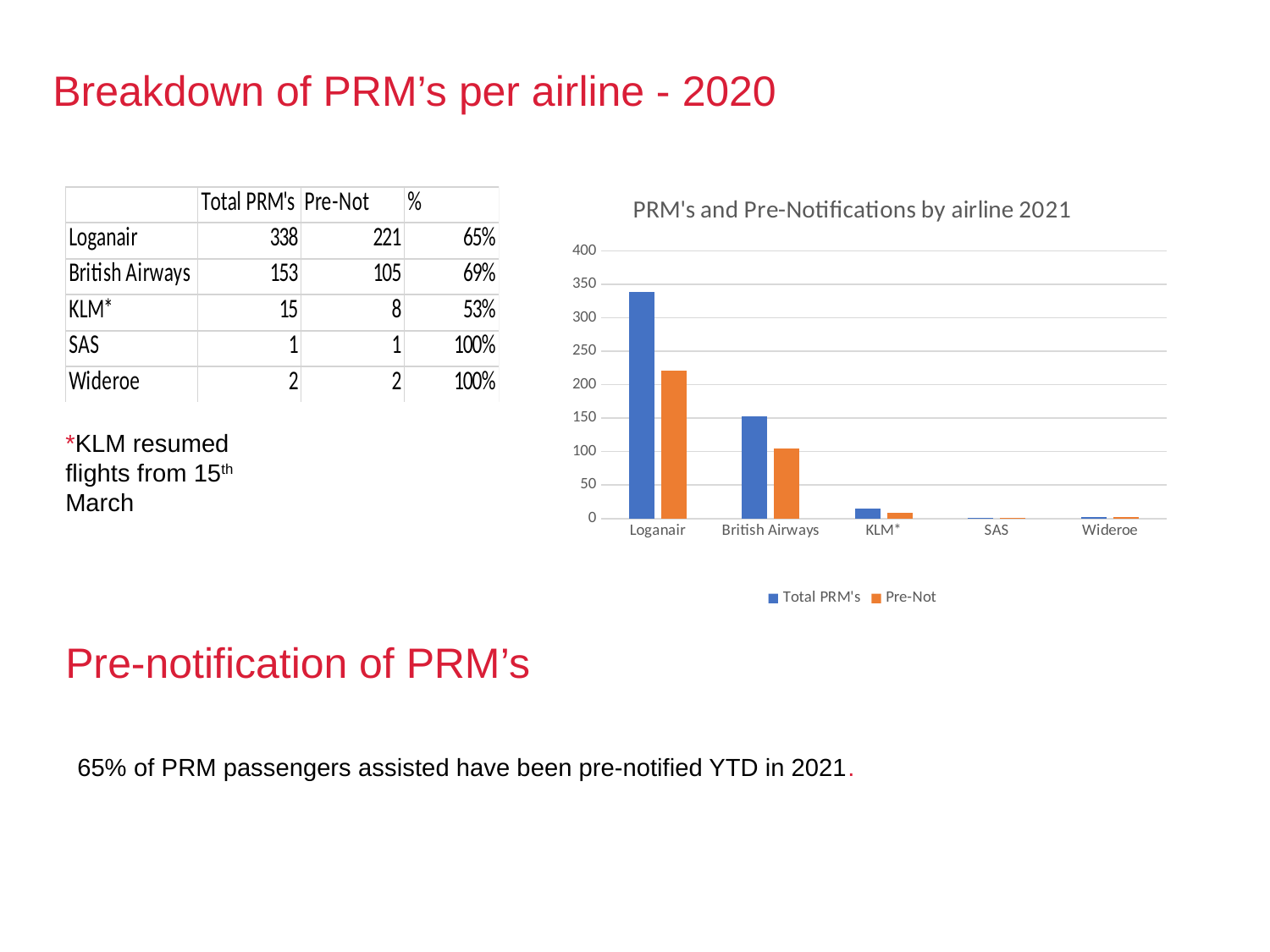
Is the Pre-Not value for British Airways greater or less than 150? less According to the table on the slide, what is the Pre-Not value for Loganair? 221 Using the values in the table, what is the difference between Total PRM's and Pre-Not for Loganair? 117 How many airlines are shown on the x axis of the chart? 5 What is the title of the chart? PRM's and Pre-Notifications by airline 2021 According to the table on the slide, what is the Total PRM's value for British Airways? 153 Is the Total PRM's value for Loganair greater or less than 300? greater Is the Pre-Not value for Loganair greater or less than 200? greater Which is larger for British Airways: Total PRM's or Pre-Not? Total PRM's Which airline has the highest Total PRM's value in the chart? Loganair How many series does the chart legend list? 2 What kind of chart is shown on the slide? bar chart